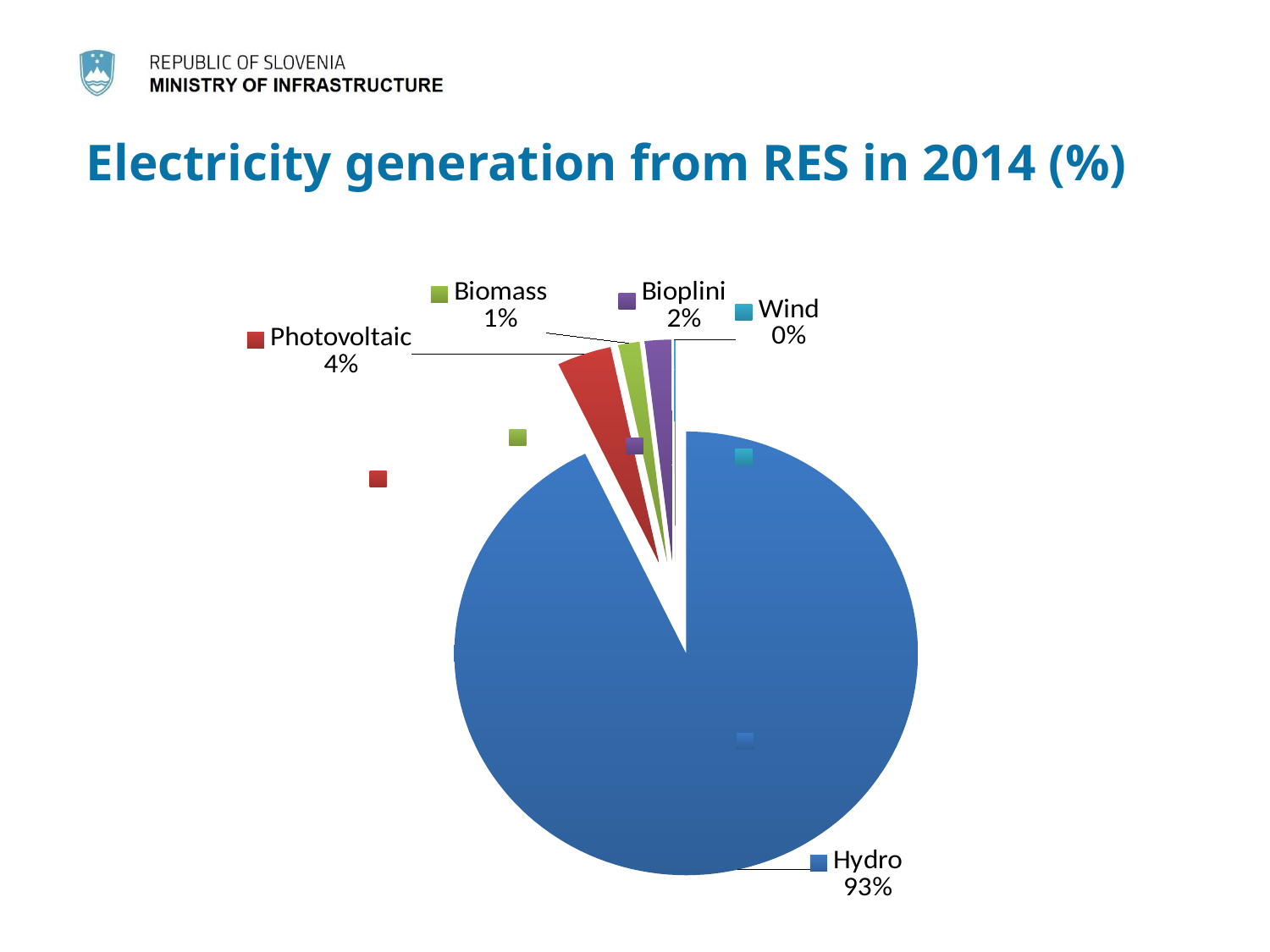
What is the difference in percentage points between Hydro and Photovoltaic? 89 What is the value shown for Biomass? 1% Which category has the largest share of the pie? Hydro How many categories are shown in the pie chart? 5 Which is larger, Photovoltaic or Bioplini? Photovoltaic What is the title of the chart on the slide? Electricity generation from RES in 2014 (%) What is the value shown for Bioplini? 2% What is the value shown for Wind? 0% What is the value shown for Photovoltaic? 4% What share of electricity generation from RES in 2014 does Hydro account for? 93% What kind of chart is shown on the slide? Pie chart Which category has the smallest share of the pie? Wind